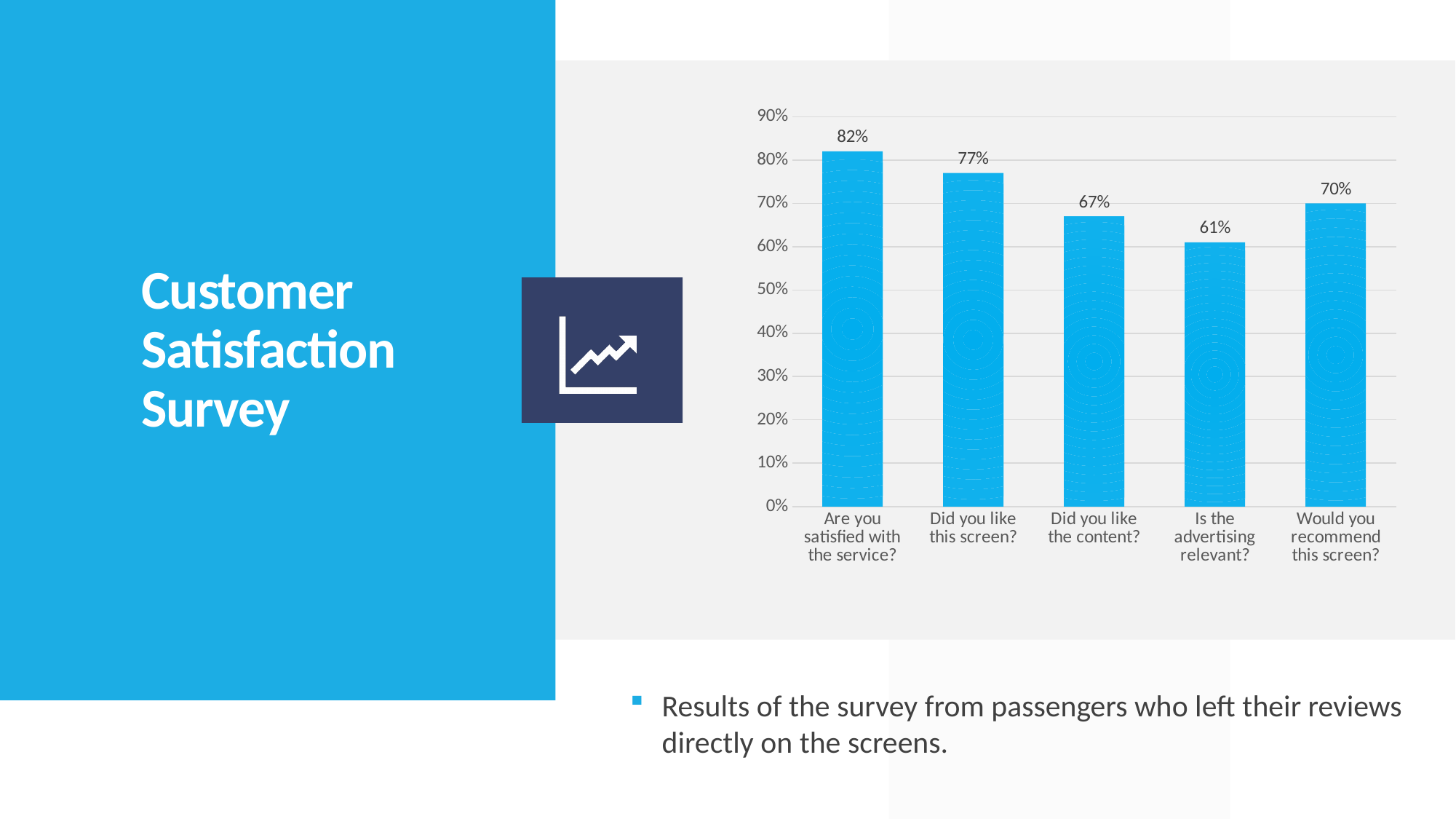
What is the value for "Did you like this screen?" 77% What is the value for "Is the advertising relevant?" 61% What is the difference between the values for "Are you satisfied with the service?" and "Is the advertising relevant?" 21% What is the value for "Would you recommend this screen?" 70% What kind of chart is shown on the slide? bar chart What percentage of respondents answered yes to "Are you satisfied with the service?" 82% Which is larger: the value for "Did you like the content?" or the value for "Would you recommend this screen?" Would you recommend this screen? What is the title of the slide containing the chart? Customer Satisfaction Survey How many survey questions are shown on the chart? 5 Which survey question has the lowest value? Is the advertising relevant? Is the value for "Did you like the content?" greater or less than 60%? greater Which survey question has the highest value? Are you satisfied with the service?